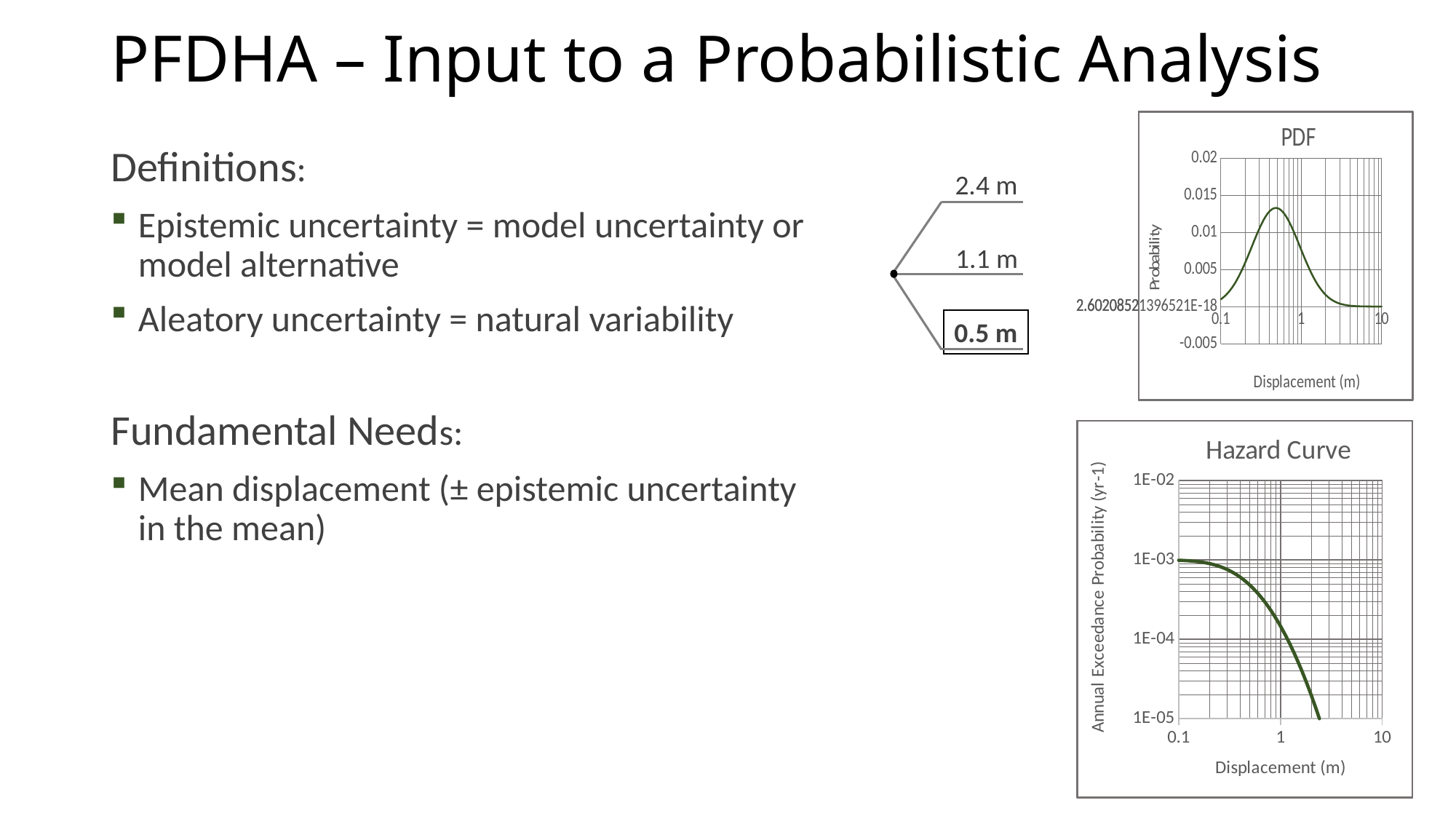
What kind of chart is the Hazard Curve chart? line chart What is the y-axis label of the Hazard Curve chart? Annual Exceedance Probability (yr-1) In the PDF chart, is the probability at a displacement of 10 m greater or less than 0.005? less In the Hazard Curve chart, do the values rise or fall as displacement increases? fall What is the x-axis label of the Hazard Curve chart? Displacement (m) What kind of chart is the PDF chart? line chart In the Hazard Curve chart, is the annual exceedance probability at a displacement of 1 m greater or less than 1E-03? less In the Hazard Curve chart, is the annual exceedance probability at a displacement of 0.1 m greater or less than 1E-04? greater